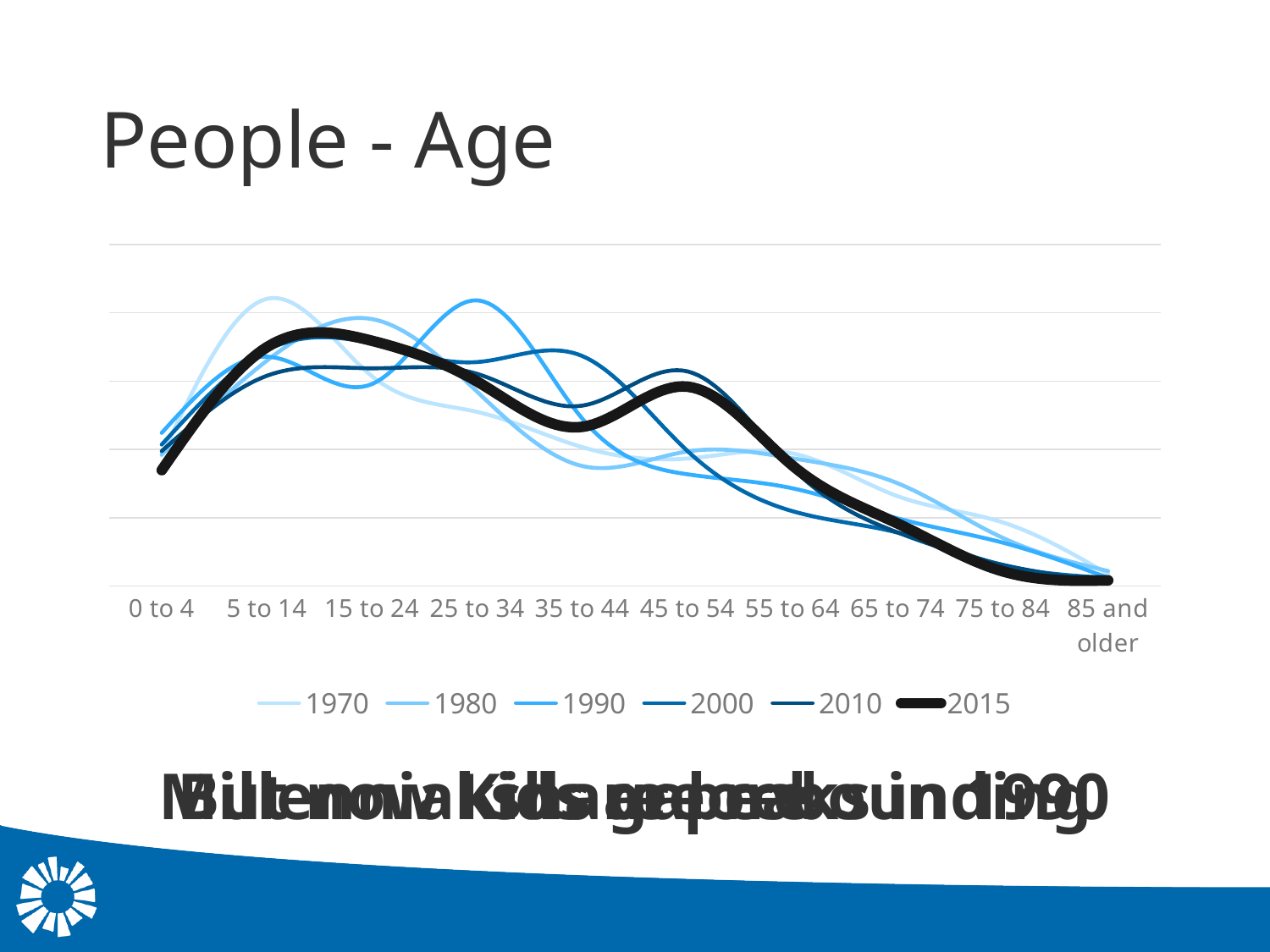
For the 2015 series, which is larger: the value for 45 to 54 or the value for 65 to 74? 45 to 54 For the 2015 series, which is larger: the value for 0 to 4 or the value for 85 and older? 0 to 4 Which age category has the highest value for the 1990 series? 25 to 34 What kind of chart is shown on the slide? Line chart Does the 2015 series rise or fall from 45 to 54 through to 85 and older? Fall What is the title of the slide containing the chart? People - Age How many series does the legend list? 6 Which series is drawn as the thick black line? 2015 Do all series rise or fall from 0 to 4 to 5 to 14? Rise How many age categories are shown along the x axis? 10 Which age category has the lowest value for the 2015 series? 85 and older Which age category has the highest value for the 1970 series? 5 to 14